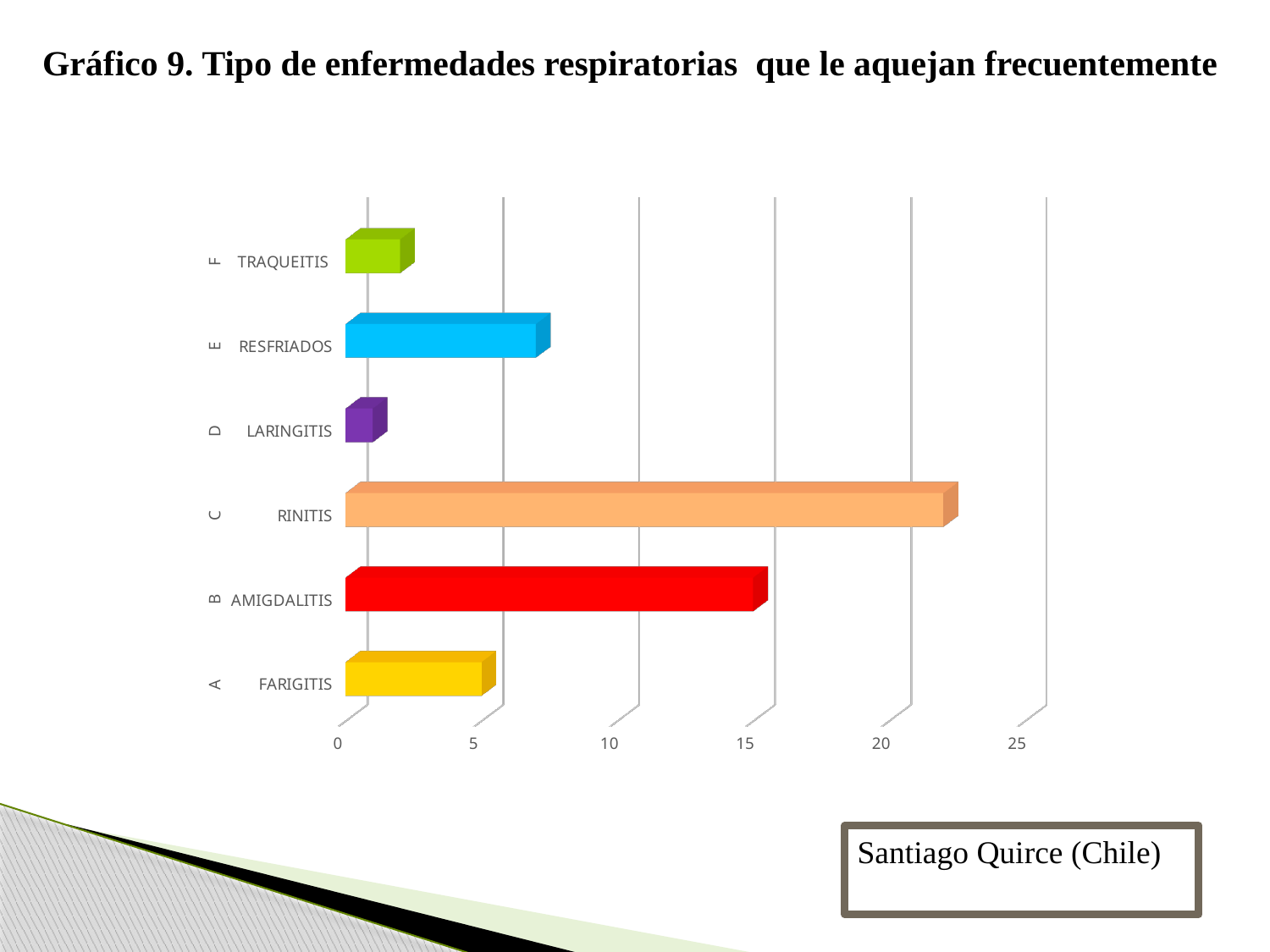
Is the value for TRAQUEITIS greater or less than 5? less What kind of chart is shown on the slide? Bar chart Which disease has the lowest value in the chart? LARINGITIS How many categories (diseases) are plotted in the chart? 6 Which has a larger value, RESFRIADOS or TRAQUEITIS? RESFRIADOS Is the value for LARINGITIS greater or less than 5? less Which has a larger value, AMIGDALITIS or RESFRIADOS? AMIGDALITIS Is the value for AMIGDALITIS greater or less than 10? greater Which disease has the highest value in the chart? RINITIS What colour is the bar for AMIGDALITIS? Red